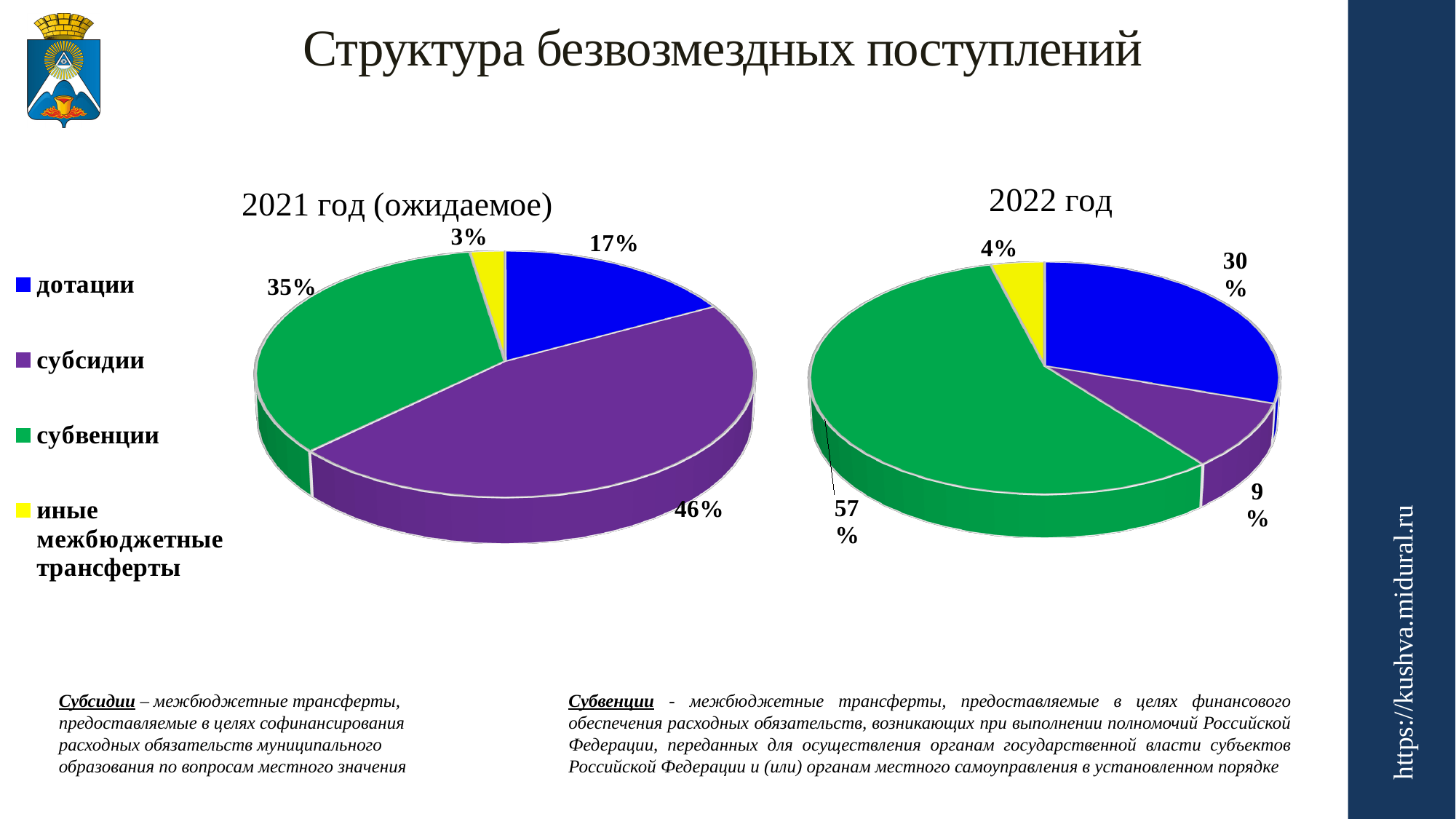
How many categories does the legend list for the pie charts? 4 Which colour represents субвенции in the pie charts? green In the "2022 год" pie chart, what share do субвенции have? 57% In the "2022 год" pie chart, which is larger: the share of дотации or the share of субсидии? дотации What is the difference between the share of дотации in the "2022 год" chart and in the "2021 год (ожидаемое)" chart? 13% In the "2022 год" pie chart, which category has the largest share? субвенции In the "2021 год (ожидаемое)" pie chart, what share do субсидии have? 46% In the "2021 год (ожидаемое)" pie chart, what share do дотации have? 17% In the "2021 год (ожидаемое)" pie chart, which category has the largest share? субсидии In the "2022 год" pie chart, what share do иные межбюджетные трансферты have? 4% What type of chart is used to show the "2022 год" data? pie chart In the "2021 год (ожидаемое)" pie chart, which category has the smallest share? иные межбюджетные трансферты